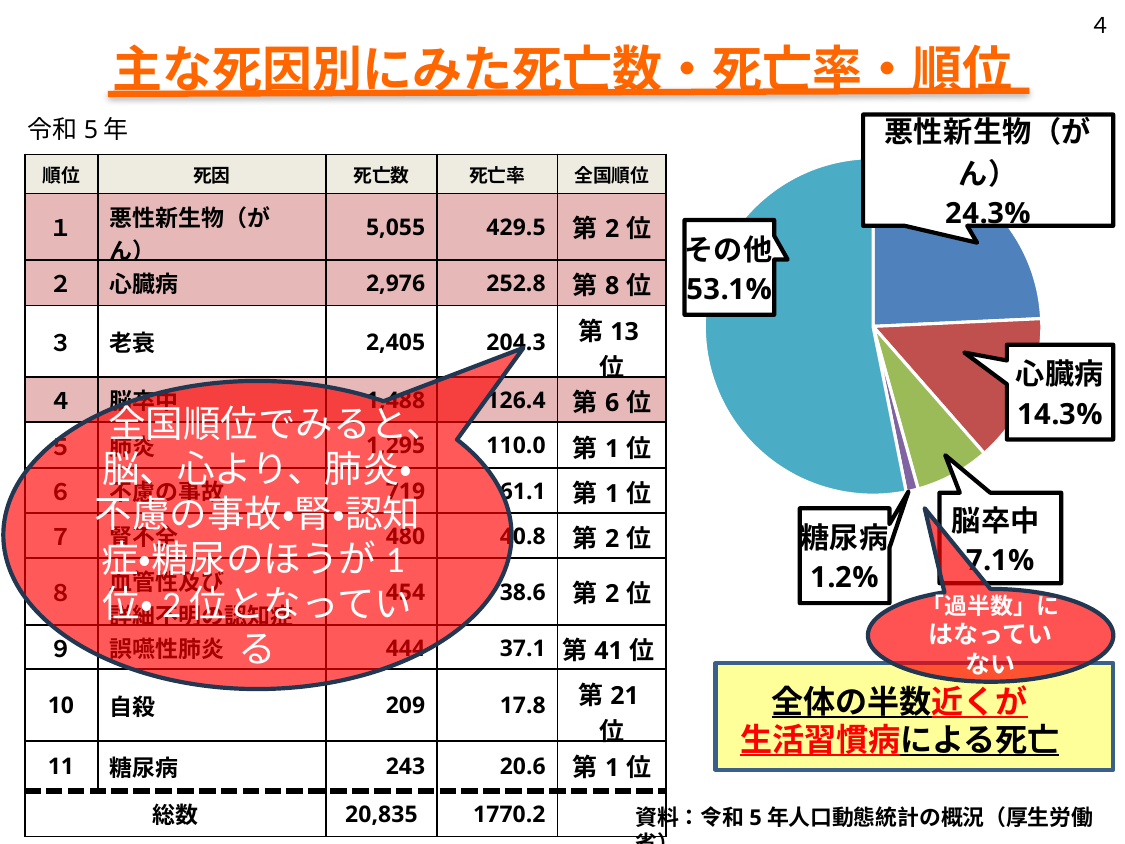
In the pie chart, what share is labelled for その他? 53.1% In the pie chart, which is larger, the share for 心臓病 or the share for 脳卒中? 心臓病 In the pie chart, what share is labelled for 悪性新生物（がん）? 24.3% How many slices does the pie chart have? 5 In the pie chart, what share is labelled for 脳卒中? 7.1% In the pie chart, what share is labelled for 糖尿病? 1.2% Which slice of the pie chart is the smallest? 糖尿病 Which slice of the pie chart is the largest? その他 In the pie chart, what is the combined share of 悪性新生物（がん）, 心臓病, 脳卒中 and 糖尿病? 46.9% In the pie chart, what share is labelled for 心臓病? 14.3% In the pie chart, what is the difference in percentage points between the share for 悪性新生物（がん） and the share for 心臓病? 10.0 What kind of chart is shown on the right side of the slide? pie chart